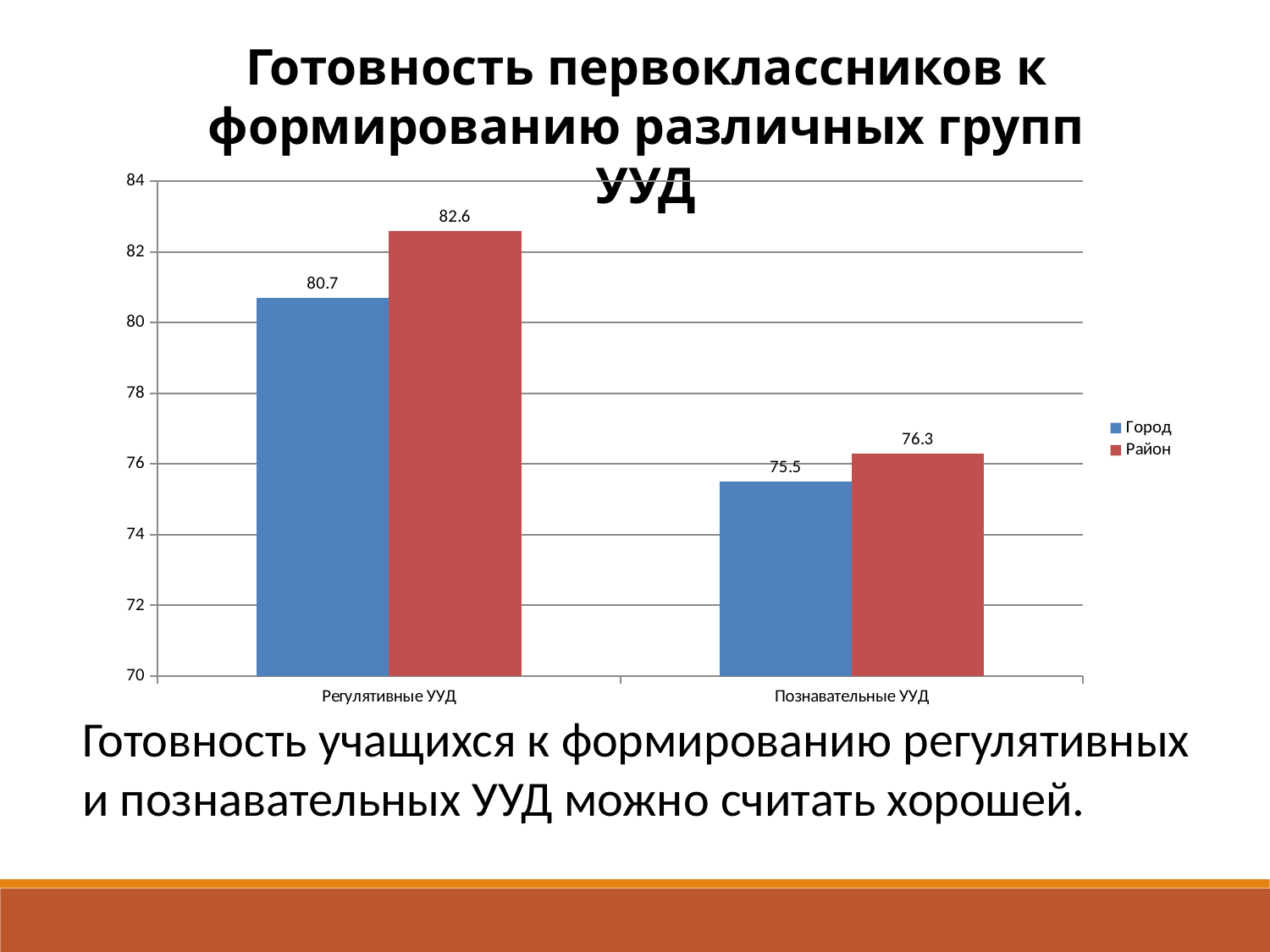
Which category has the lowest value for the Город series? Познавательные УУД What is the value for Город in the Познавательные УУД category? 75.5 What is the difference between Район and Город in the Регулятивные УУД category? 1.9 What is the value for Город in the Регулятивные УУД category? 80.7 Which category has the highest value for the Район series? Регулятивные УУД What is the value for Район in the Познавательные УУД category? 76.3 What kind of chart is shown on the slide? Bar chart How many categories are shown on the x axis? 2 Which is larger in the Познавательные УУД category, Город or Район? Район What is the difference between Район and Город in the Познавательные УУД category? 0.8 What is the value for Район in the Регулятивные УУД category? 82.6 How many series does the legend list? 2